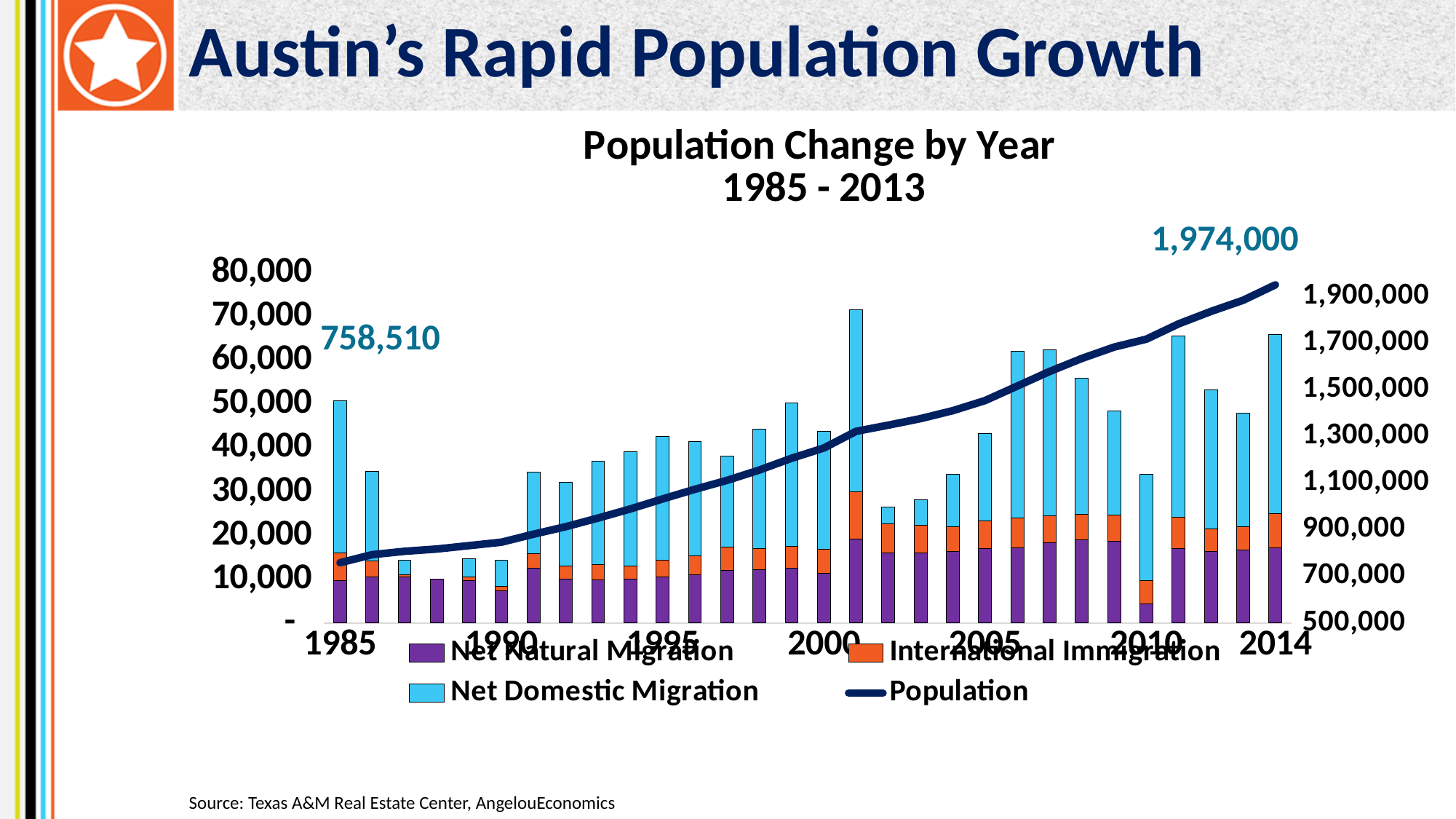
Does the Population line rise or fall from 1985 to 2014? Rise What kind of chart is shown on the slide? Combination stacked bar and line chart What population value is labelled at the start of the Population line in 1985? 758,510 Which colour represents Net Domestic Migration in the chart? Light blue How many series does the chart legend list? 4 What population value is labelled at the end of the Population line in 2014? 1,974,000 Which year has the shortest stacked bar of population change? 1988 Is the total stacked bar for 1985 greater or less than 40,000? greater By how much did the labelled Population value grow from 758,510 in 1985 to 1,974,000 in 2014? 1,215,490 Which year has the taller stacked bar, 1985 or 1986? 1985 What is the title of the chart? Population Change by Year 1985 - 2013 Which year has the tallest stacked bar of population change? 2001